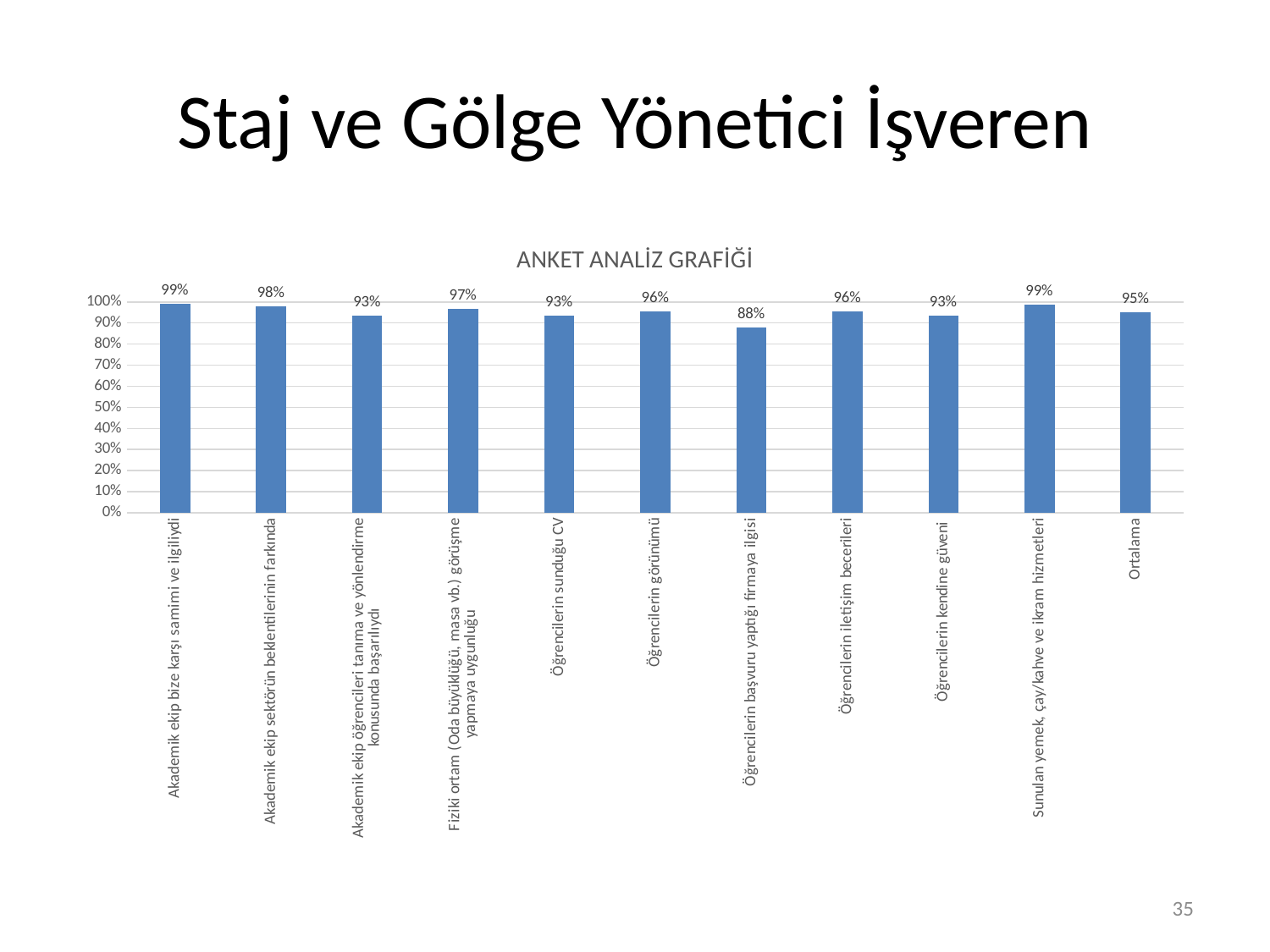
What is the difference between the values for "Akademik ekip bize karşı samimi ve ilgiliydi" and "Öğrencilerin başvuru yaptığı firmaya ilgisi"? 11% Which is larger, the value for "Öğrencilerin görünümü" or the value for "Öğrencilerin kendine güveni"? Öğrencilerin görünümü What kind of chart is shown on the slide? Bar chart What is the value for "Akademik ekip sektörün beklentilerinin farkında"? 98% How many categories are shown on the x axis? 11 What is the value for "Fiziki ortam (Oda büyüklüğü, masa vb.) görüşme yapmaya uygunluğu"? 97% What is the title of the chart? ANKET ANALİZ GRAFİĞİ What is the difference between the values for "Ortalama" and "Öğrencilerin kendine güveni"? 2% Which category has the lowest value? Öğrencilerin başvuru yaptığı firmaya ilgisi What is the value for "Ortalama"? 95% What is the value for "Öğrencilerin sunduğu CV"? 93% What is the value for "Öğrencilerin başvuru yaptığı firmaya ilgisi"? 88%